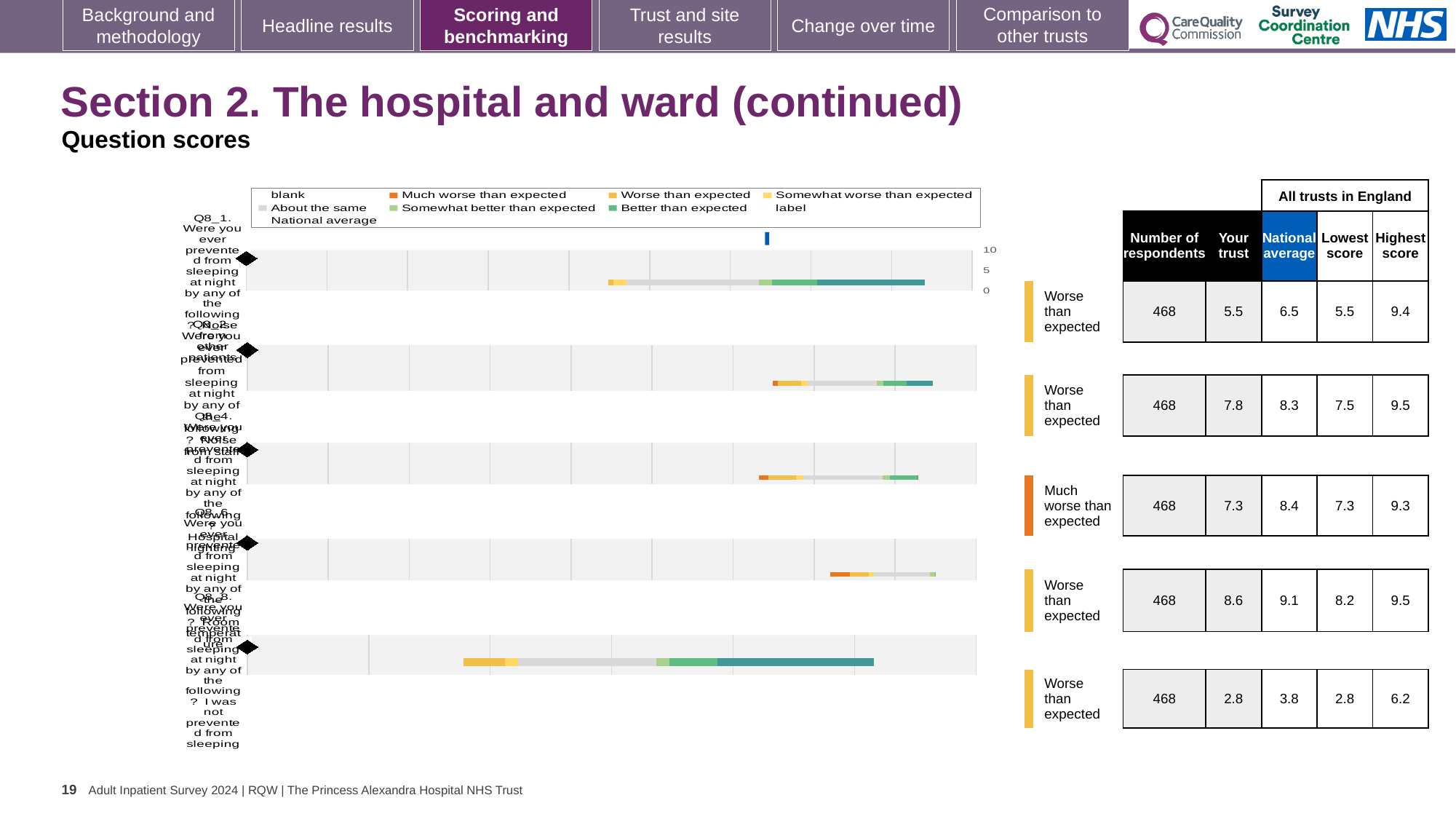
How many question rows (bars) are plotted in the chart? 5 In the table beside the chart, is the 'Your trust' score for the second row (Q8_2) higher or lower than the national average? lower In the table beside the chart, which row has the highest 'Your trust' score? Q8_6 (8.6) In the table beside the chart, which row has the lowest 'Your trust' score? Q8_8 (2.8) In the chart legend, which category is shown in dark orange? Much worse than expected In the table beside the chart, what is the national average for the last row (Q8_8)? 3.8 How many respondents are listed for each question in the table beside the chart? 468 What kind of chart is shown on the slide? bar chart In the table beside the chart, what is the difference between the national average and 'Your trust' score for the third row (Q8_4)? 1.1 In the chart legend, which category is shown in dark teal? Better than expected In the table beside the chart, what is the 'Your trust' score for the first row (Q8_1)? 5.5 In the table beside the chart, what is the highest score for the third row (Q8_4)? 9.3